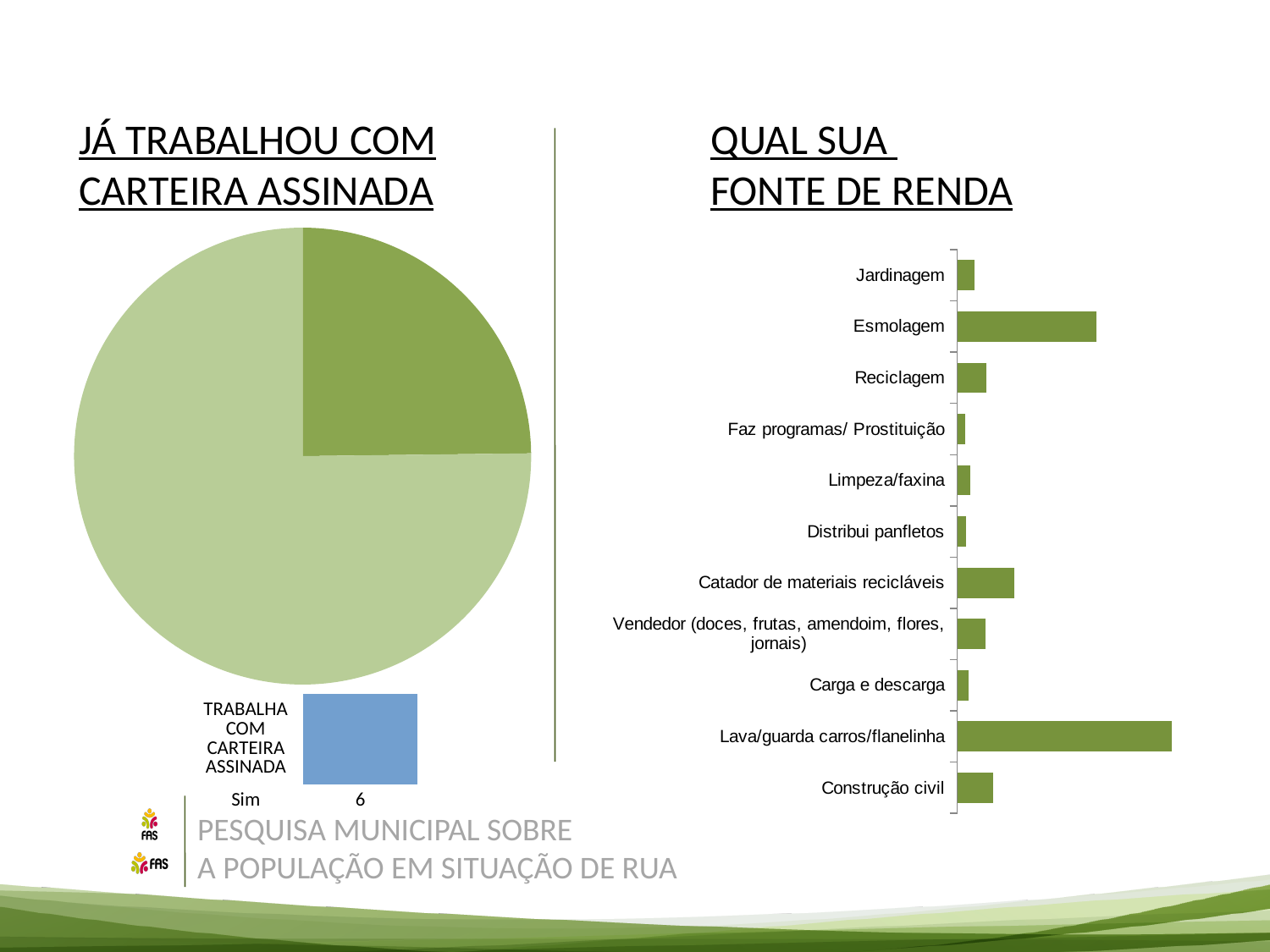
In the chart titled "QUAL SUA FONTE DE RENDA", which category has the longest bar? Lava/guarda carros/flanelinha In the chart titled "JÁ TRABALHOU COM CARTEIRA ASSINADA", which slice is larger: the light green slice or the dark green slice? the light green slice In the chart titled "QUAL SUA FONTE DE RENDA", which bar is longer: Construção civil or Carga e descarga? Construção civil In the chart titled "JÁ TRABALHOU COM CARTEIRA ASSINADA", how many slices does the pie have? 2 What kind of chart is the chart titled "QUAL SUA FONTE DE RENDA"? bar chart In the chart titled "QUAL SUA FONTE DE RENDA", which bar is longer: Catador de materiais recicláveis or Vendedor (doces, frutas, amendoim, flores, jornais)? Catador de materiais recicláveis What is the title of the bar chart on the right side of the slide? QUAL SUA FONTE DE RENDA In the chart titled "QUAL SUA FONTE DE RENDA", how many categories are plotted? 11 In the chart titled "QUAL SUA FONTE DE RENDA", which category has the second-longest bar? Esmolagem What kind of chart is the chart titled "JÁ TRABALHOU COM CARTEIRA ASSINADA"? pie chart